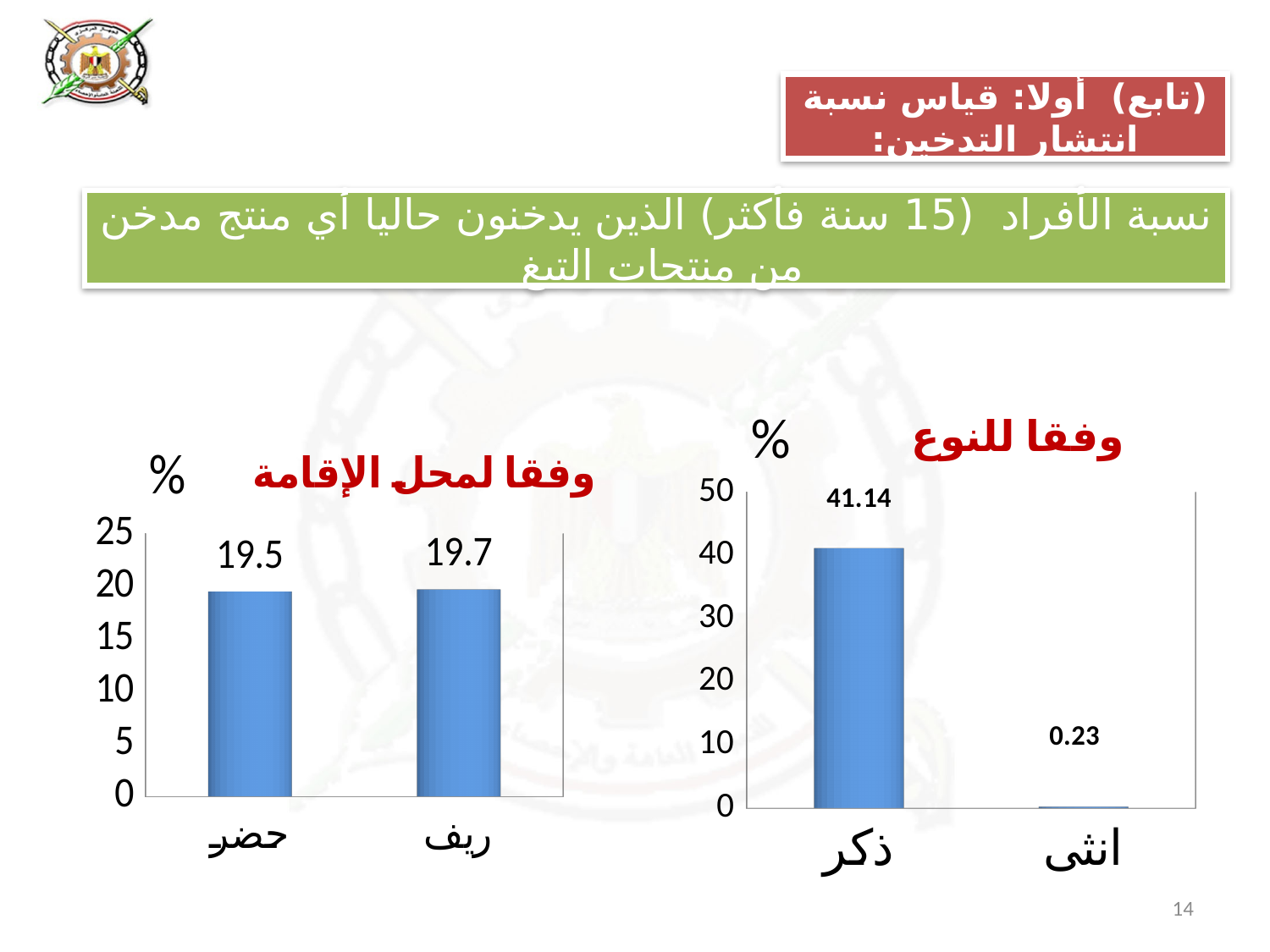
In the chart titled وفقا لمحل الإقامة, what is the value for حضر? 19.5 In the chart titled وفقا لمحل الإقامة, what is the difference between the values for ريف and حضر? 0.2 In the chart titled وفقا للنوع, what is the value for انثى? 0.23 In the chart titled وفقا للنوع, which category has the lowest value? انثى How many categories are shown in the chart titled وفقا لمحل الإقامة? 2 In the chart titled وفقا للنوع, what is the difference between the values for ذكر and انثى? 40.91 In the chart titled وفقا للنوع, is the value for ذكر greater or less than 40? greater What kind of chart is the chart titled وفقا للنوع? bar chart In the chart titled وفقا لمحل الإقامة, what is the value for ريف? 19.7 In the chart titled وفقا للنوع, what is the value for ذكر? 41.14 In the chart titled وفقا للنوع, which category has the highest value? ذكر In the chart titled وفقا لمحل الإقامة, which is larger, the value for حضر or the value for ريف? ريف